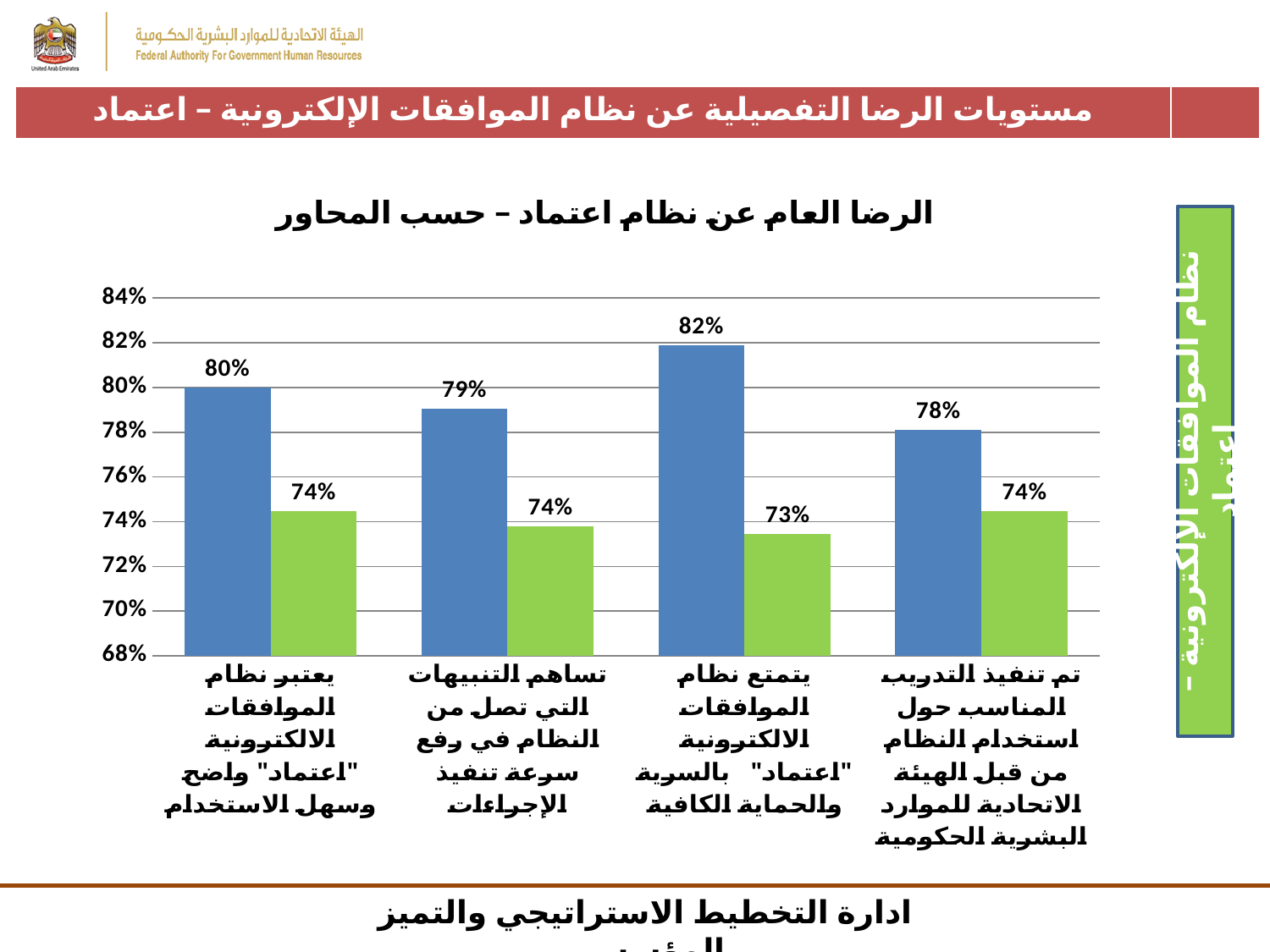
Is the green bar for "تساهم التنبيهات التي تصل من النظام في رفع سرعة تنفيذ الإجراءات" greater or less than 76%? less How many categories are shown on the x axis of the chart? 4 What is the difference between the blue bar and the green bar for the category "يتمتع نظام الموافقات الالكترونية "اعتماد" بالسرية والحماية الكافية"? 9% What is the value of the blue bar for the category "يتمتع نظام الموافقات الالكترونية "اعتماد" بالسرية والحماية الكافية"? 82% Which category has the highest blue bar? يتمتع نظام الموافقات الالكترونية "اعتماد" بالسرية والحماية الكافية Which is larger: the blue bar for "يعتبر نظام الموافقات الالكترونية "اعتماد" واضح وسهل الاستخدام" or the blue bar for "تم تنفيذ التدريب المناسب حول استخدام النظام من قبل الهيئة الاتحادية للموارد البشرية الحكومية"? يعتبر نظام الموافقات الالكترونية "اعتماد" واضح وسهل الاستخدام What is the value of the green bar for the category "يعتبر نظام الموافقات الالكترونية "اعتماد" واضح وسهل الاستخدام"? 74% What kind of chart is shown on the slide? bar chart What is the value of the green bar for the category "يتمتع نظام الموافقات الالكترونية "اعتماد" بالسرية والحماية الكافية"? 73% What is the value of the blue bar for the category "تساهم التنبيهات التي تصل من النظام في رفع سرعة تنفيذ الإجراءات"? 79% What is the title of the chart? الرضا العام عن نظام اعتماد - حسب المحاور Which category has the lowest blue bar? تم تنفيذ التدريب المناسب حول استخدام النظام من قبل الهيئة الاتحادية للموارد البشرية الحكومية